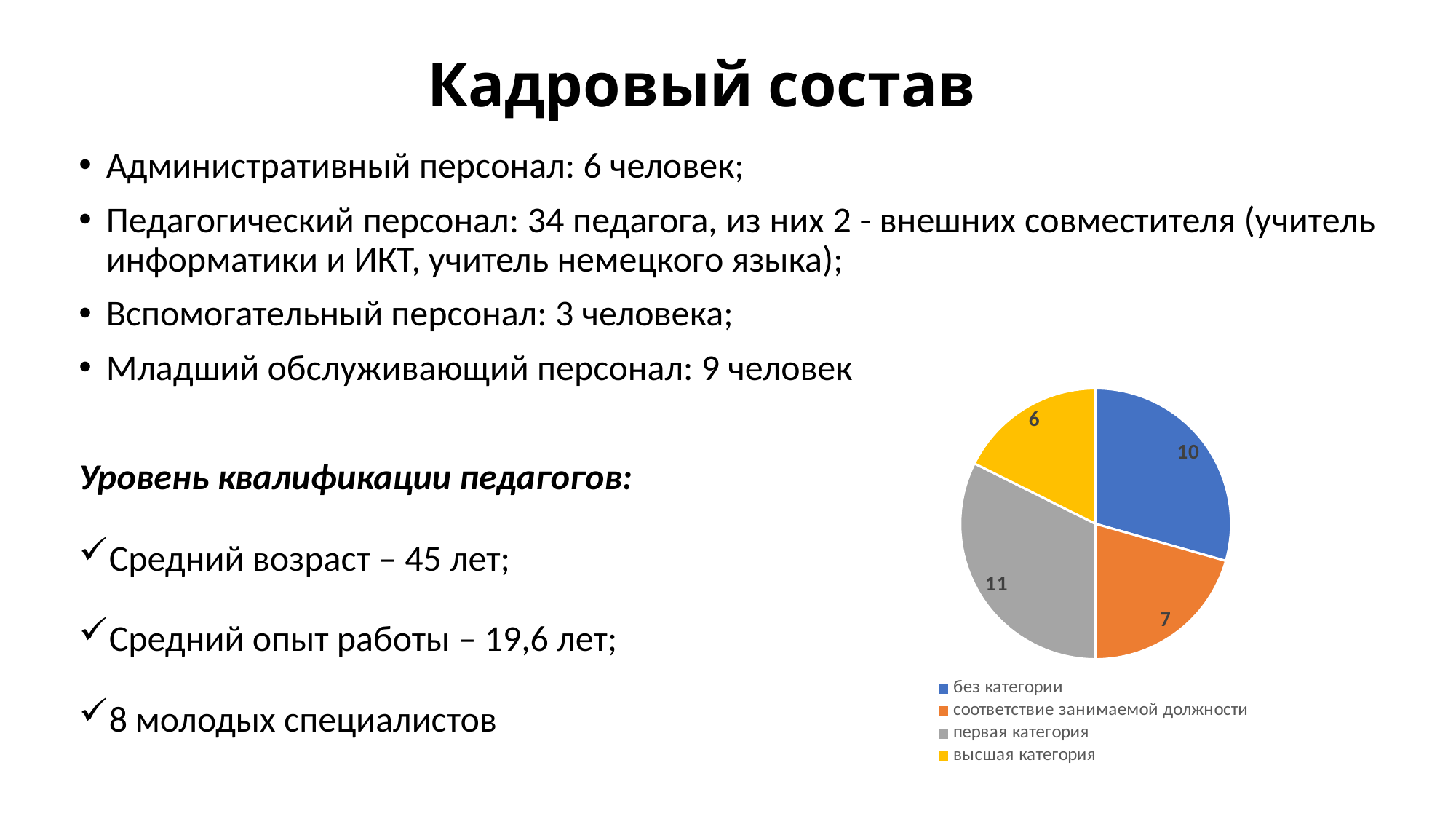
What is the difference between the values for 'первая категория' and 'высшая категория'? 5 What is the total of all the values shown in the pie chart? 34 What is the value for 'первая категория' in the pie chart? 11 Which category has the largest slice in the pie chart? первая категория What is the value for 'соответствие занимаемой должности' in the pie chart? 7 Which category has the smallest slice in the pie chart? высшая категория How many entries does the legend of the pie chart list? 4 What kind of chart is shown on the slide? pie chart What is the value for 'без категории' in the pie chart? 10 What is the value for 'высшая категория' in the pie chart? 6 How many slices does the pie chart have? 4 Which is larger: the value for 'без категории' or the value for 'соответствие занимаемой должности'? без категории